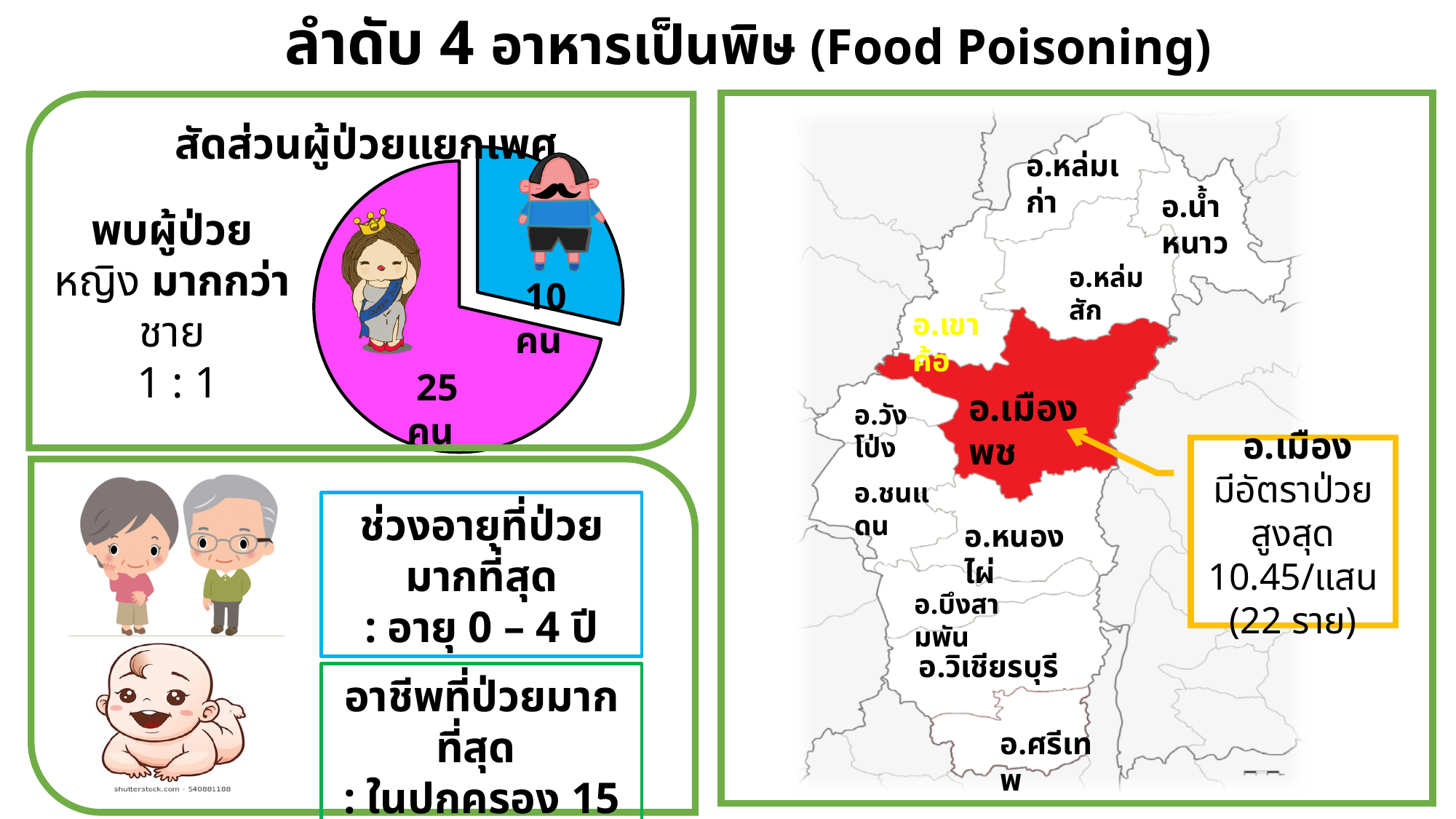
What is the title of the pie chart? สัดส่วนผู้ป่วยแยกเพศ Which slice of the pie chart is the largest? the pink (female) slice, 25 คน Which slice of the pie chart is the smallest? the blue (male) slice, 10 คน What value is printed on the pink (female) slice of the pie chart? 25 คน What colour is the slice representing 10 คน in the pie chart? blue What value is printed on the blue (male) slice of the pie chart? 10 คน What is the difference between the pink (female) slice and the blue (male) slice in the pie chart? 15 คน What kind of chart is shown in the top-left panel of the slide? pie chart What is the total of the two slices in the pie chart? 35 คน In the pie chart, is the blue (male) slice larger or smaller than the pink (female) slice? smaller How many slices does the pie chart have? 2